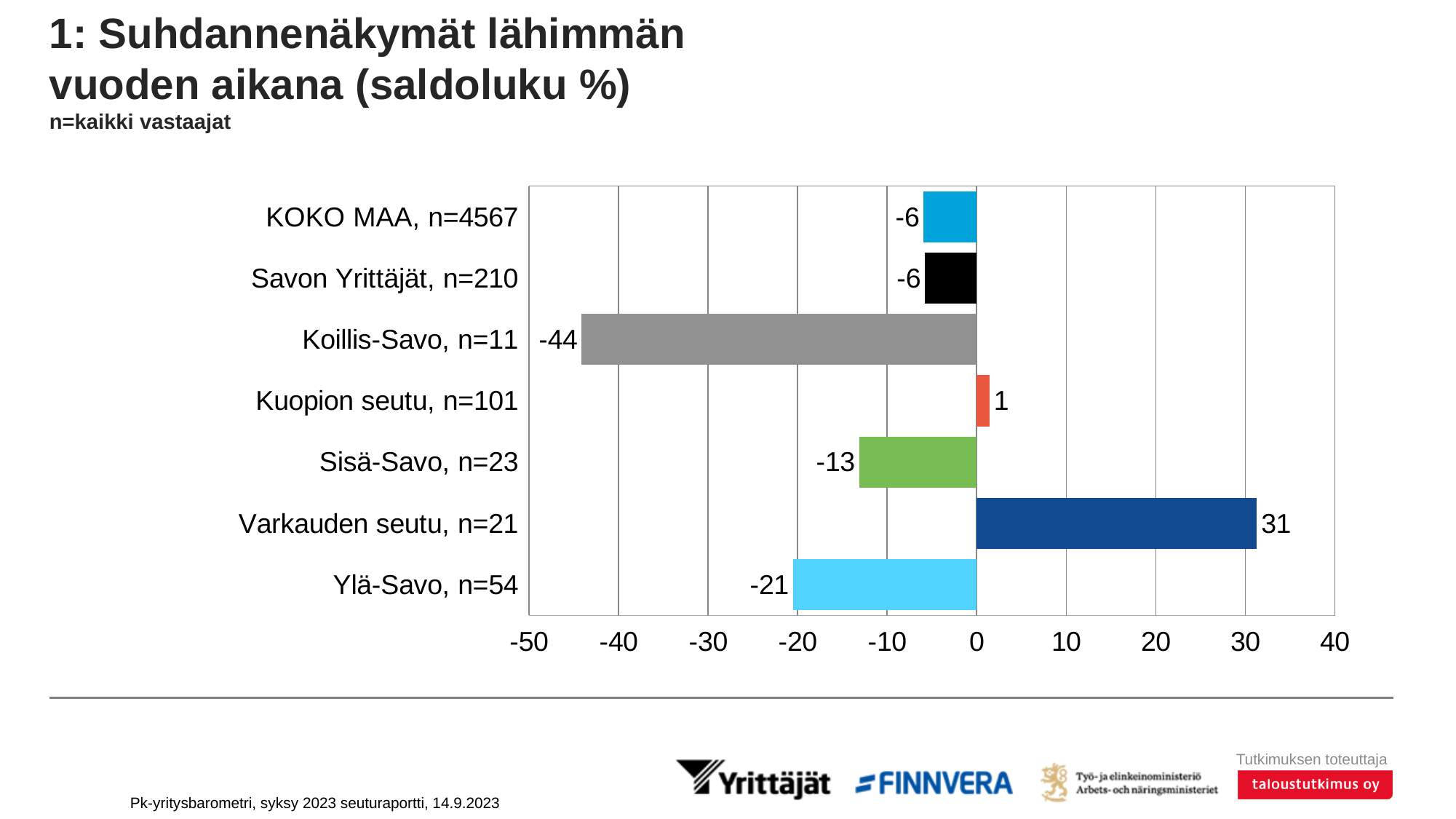
Is the value for Koillis-Savo, n=11 greater or less than -40? less Which has a larger value, Sisä-Savo, n=23 or Kuopion seutu, n=101? Kuopion seutu, n=101 What is the value for Kuopion seutu, n=101? 1 How many categories are shown in the chart? 7 What is the value for Savon Yrittäjät, n=210? -6 What is the value for Ylä-Savo, n=54? -21 Which category has the lowest value? Koillis-Savo, n=11 What kind of chart is shown on the slide? bar chart What is the value for Koillis-Savo, n=11? -44 What is the difference between the values for Varkauden seutu, n=21 and Ylä-Savo, n=54? 52 Which category has the highest value? Varkauden seutu, n=21 What is the value for Varkauden seutu, n=21? 31